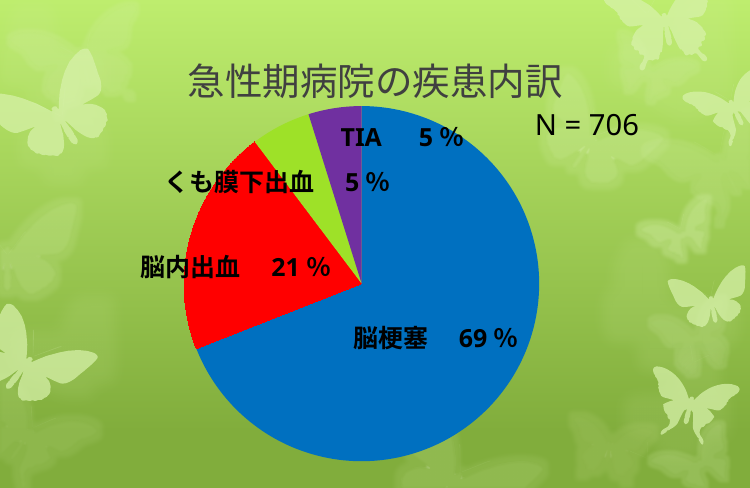
Which category has the largest share of the pie? 脳梗塞 What percentage is shown for くも膜下出血? 5 % Which has a larger share, 脳内出血 or TIA? 脳内出血 What is the value of N shown on the slide? 706 What share of the pie does 脳梗塞 account for? 69 % What percentage is shown for TIA? 5 % What is the difference in percentage points between 脳梗塞 and 脳内出血? 48 % What kind of chart is shown on the slide? Pie chart What is the combined share of くも膜下出血 and TIA? 10 % How many categories are shown in the pie chart? 4 What is the title of the chart? 急性期病院の疾患内訳 What percentage is shown for 脳内出血? 21 %